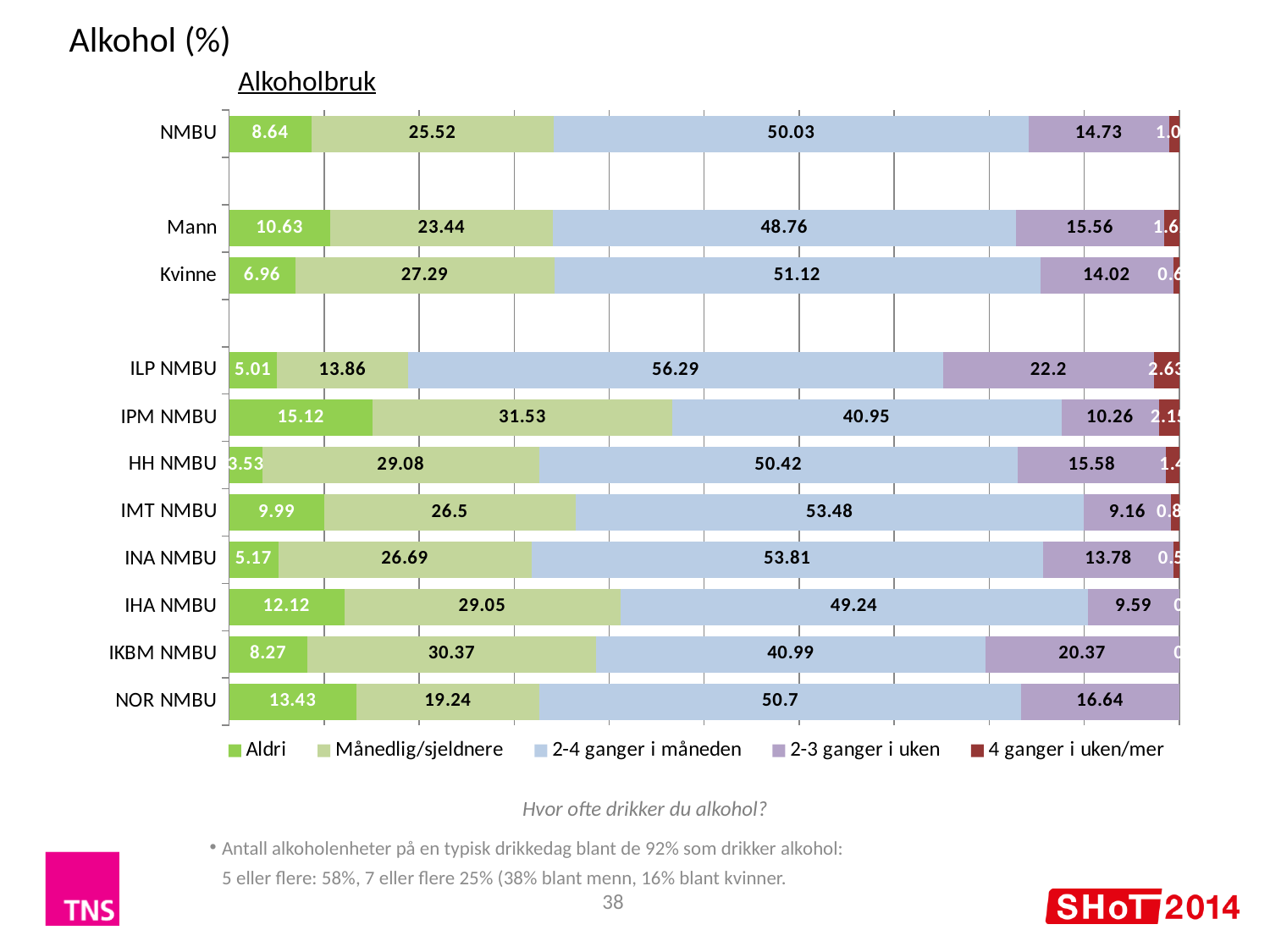
What is the difference between the 'Månedlig/sjeldnere' values for IPM NMBU and ILP NMBU? 17.67 Which has the larger '2-4 ganger i måneden' value, Mann or Kvinne? Kvinne Which category has the highest '2-3 ganger i uken' value? ILP NMBU What is the difference between the 'Aldri' values for Mann and Kvinne? 3.67 Which category has the lowest 'Aldri' value? HH NMBU What kind of chart is shown on the slide? Stacked bar chart What is the value of the '2-4 ganger i måneden' segment for ILP NMBU? 56.29 What is the value of the 'Aldri' segment for IPM NMBU? 15.12 Which category has the highest 'Aldri' value? IPM NMBU How many series does the legend list? 5 How many categories are shown on the y axis of the chart? 11 What is the value of the '2-3 ganger i uken' segment for IKBM NMBU? 20.37